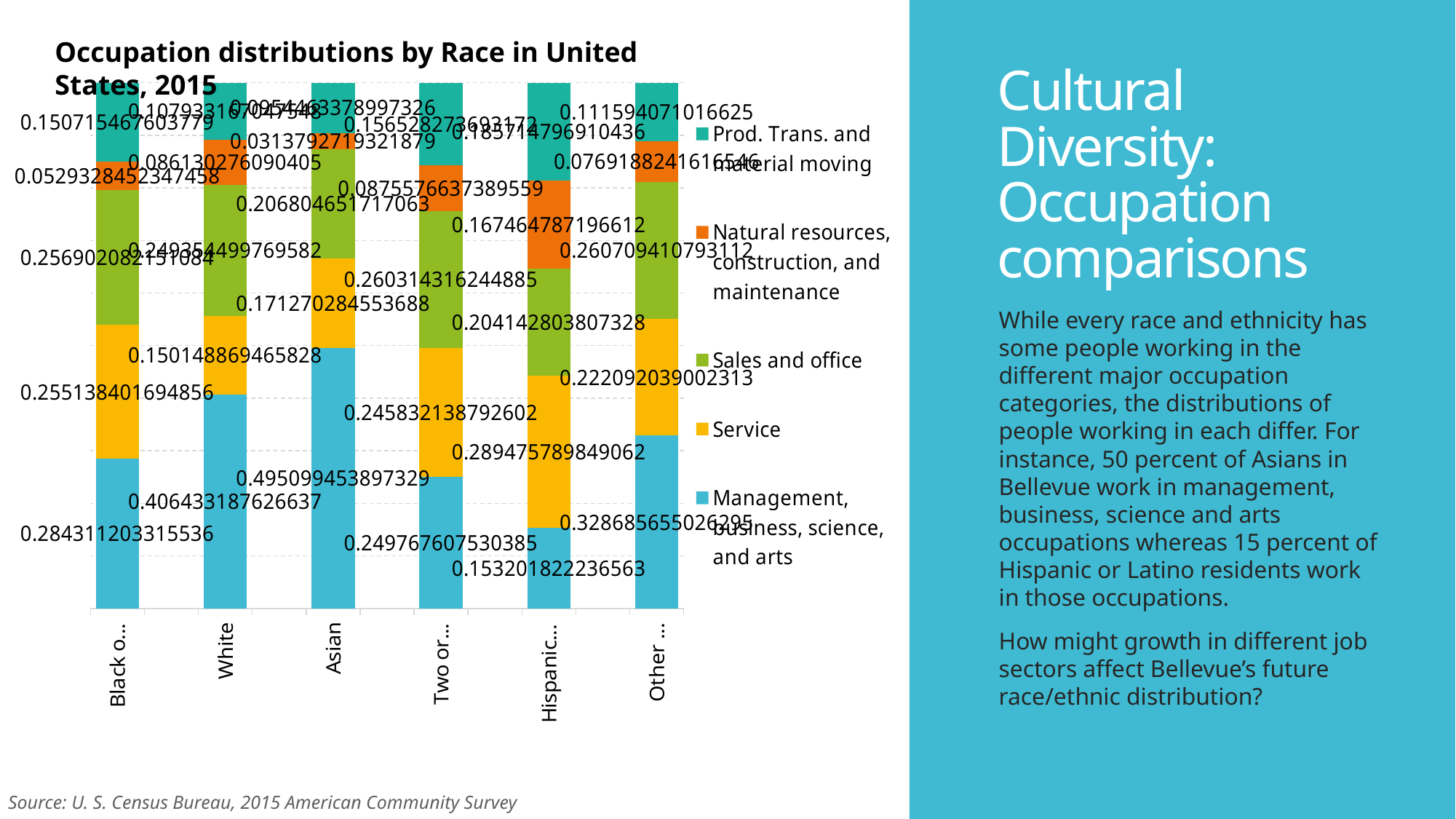
What type of chart is shown on the slide? Stacked bar chart How many race/ethnicity categories are shown on the x axis of the chart? 6 Which category has the lowest value for Management, business, science, and arts? Hispanic How many series does the chart's legend list? 5 Which has a larger Management, business, science, and arts value: White or Black? White Which category has the highest value for Management, business, science, and arts? Asian What is the value of the Natural resources, construction, and maintenance segment for Asian? 0.0313792719321879 What is the value of the Management, business, science, and arts segment for White? 0.406433187626637 What is the value of the Management, business, science, and arts segment for Asian? 0.495099453897329 What is the title of the chart? Occupation distributions by Race in United States, 2015 What is the value of the Service segment for the Hispanic category? 0.289475789849062 What is the difference between the Management, business, science, and arts values for Asian and Hispanic? 0.341897631660766